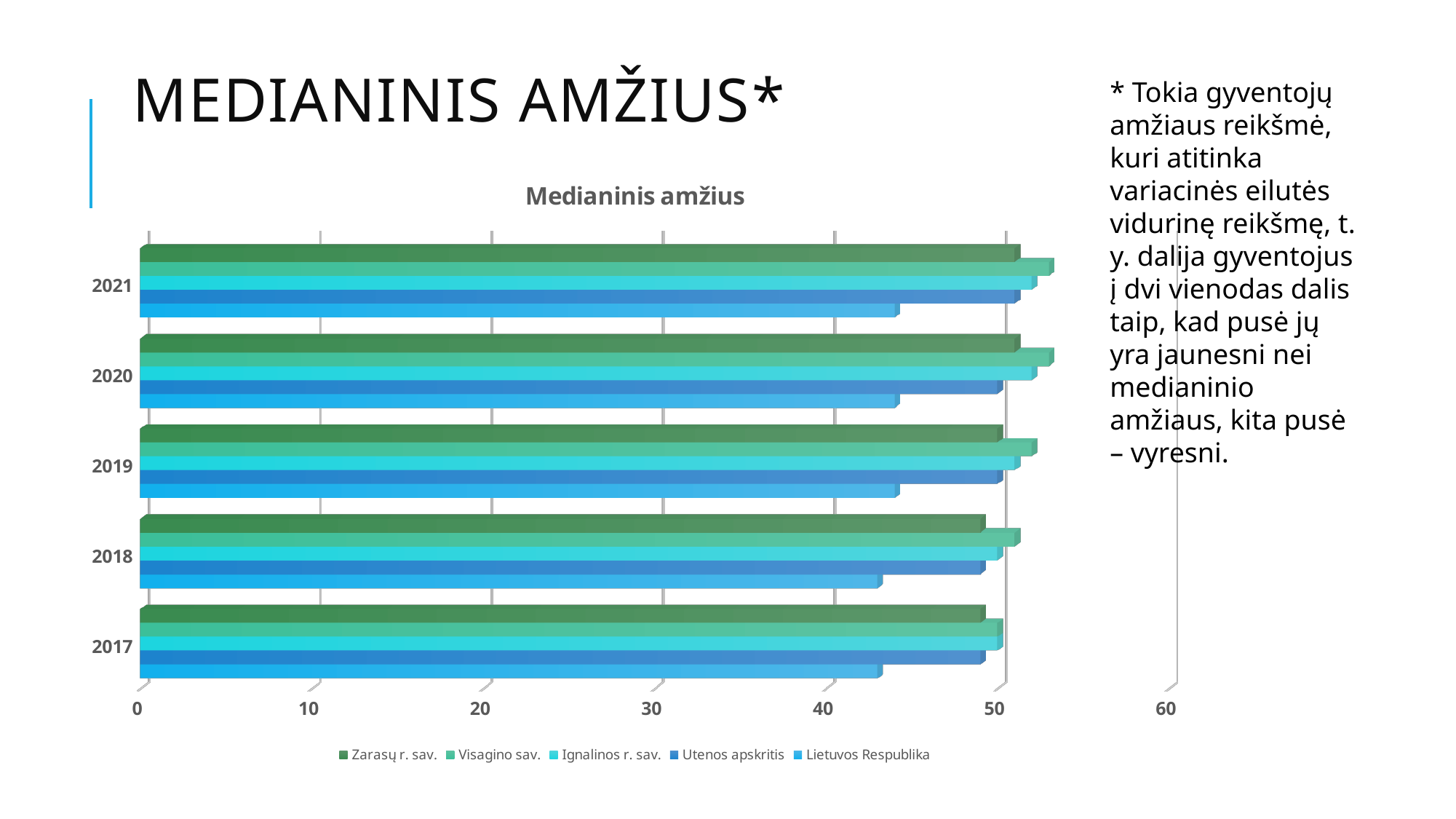
Which series is listed first in the legend? Zarasų r. sav. How many series does the legend list? 5 In 2020, which is larger: the value for Visagino sav. or the value for Lietuvos Respublika? Visagino sav. How many years (categories) are shown on the chart? 5 Is the value for Lietuvos Respublika in 2017 greater or less than 40? greater What is the title of the chart? Medianinis amžius Is the value for Visagino sav. in 2021 greater or less than 50? greater Which series has the lowest value in 2019? Lietuvos Respublika Which series has the highest value in 2021? Visagino sav. What kind of chart is shown on the slide? bar chart Is the value for Lietuvos Respublika in 2021 greater or less than 50? less